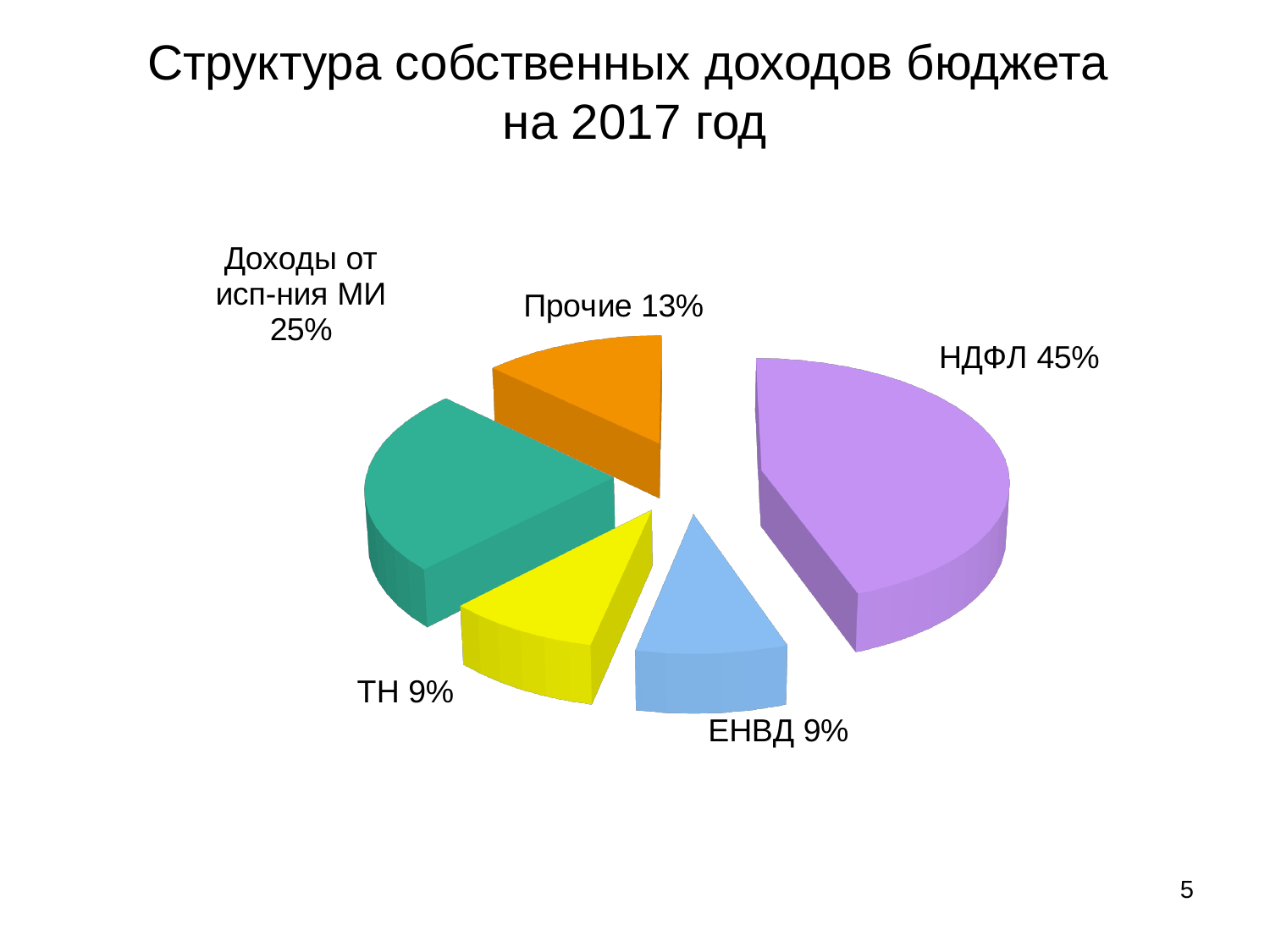
Which is larger, the share for Прочие or the share for ТН? Прочие What is the title of the chart? Структура собственных доходов бюджета на 2017 год What share of the pie does Доходы от исп-ния МИ have? 25% What kind of chart is shown on the slide? pie chart How many slices does the pie chart have? 5 What is the difference in percentage points between Доходы от исп-ния МИ and Прочие? 12 Which category has the largest share of the pie? НДФЛ What share of the pie does ЕНВД have? 9% What is the difference in percentage points between НДФЛ and Доходы от исп-ния МИ? 20 What share of the pie does Прочие have? 13% What share of the pie does НДФЛ have? 45% What colour is the НДФЛ slice? purple